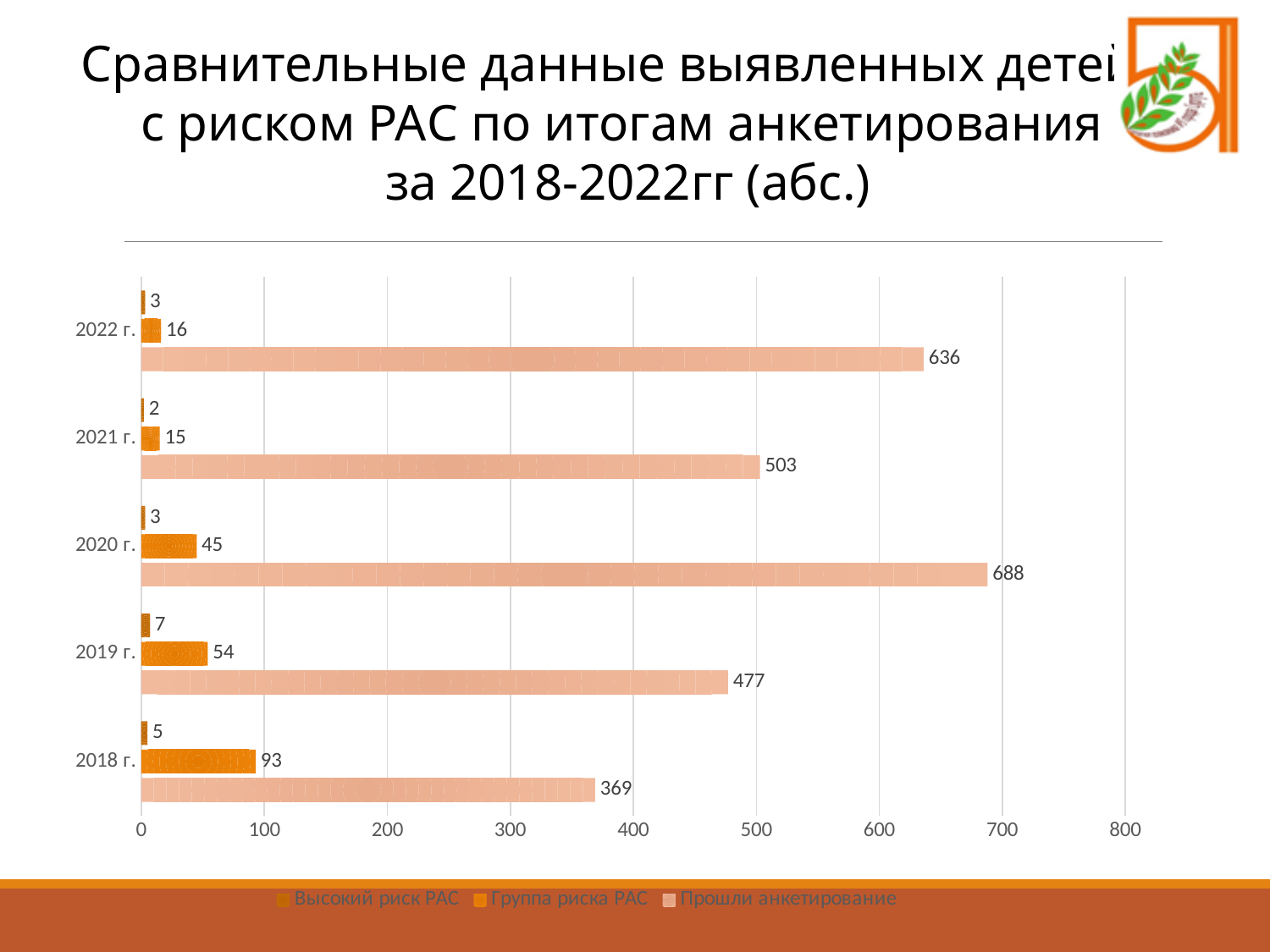
What type of chart is shown on the slide? bar chart What is the value for Группа риска РАС in 2018 г.? 93 Is the value for Прошли анкетирование in 2019 г. greater or less than 400? greater Which is larger: the Группа риска РАС value for 2019 г. or for 2020 г.? 2019 г. How many series does the legend list? 3 How many year categories are shown on the chart? 5 In which year is the value for Прошли анкетирование the highest? 2020 г. In which year is the value for Прошли анкетирование the lowest? 2018 г. What is the difference between the Прошли анкетирование values for 2022 г. and 2021 г.? 133 What is the value for Высокий риск РАС in 2019 г.? 7 Which series is shown with the light peach colour in the legend? Прошли анкетирование What is the value for Прошли анкетирование in 2020 г.? 688